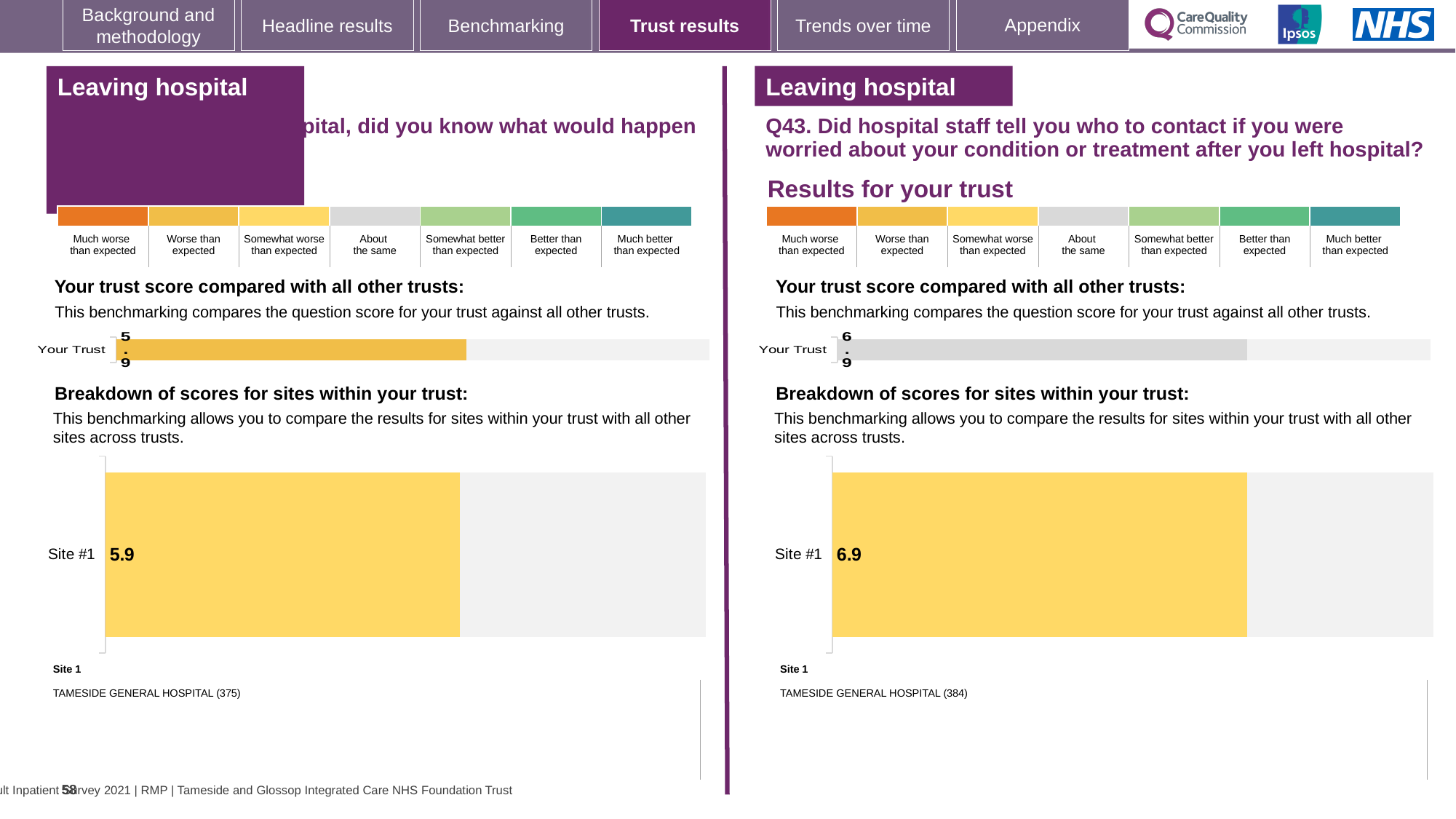
What is the difference between the Site #1 score on the Q43 panel and the Site #1 score on the left panel? 1.0 On the Q43 panel, which hospital is listed as Site 1 below the chart? TAMESIDE GENERAL HOSPITAL On the Q43 panel (right), what score is shown for Site #1 in the breakdown of sites chart? 6.9 On the left panel, what score is shown for Site #1 in the breakdown of sites chart? 5.9 On the left panel, what is the 'Your Trust' score shown in the trust benchmarking bar? 5.9 Which panel shows the higher Site #1 score, the left panel or the Q43 panel on the right? Q43 panel (right) How many sites are shown in the breakdown of sites chart on the Q43 panel? 1 What type of chart is used for the breakdown of scores for sites within your trust on the Q43 panel? Bar chart On the Q43 panel, what number appears in brackets after the Site 1 hospital name? 384 How many bars are plotted in the 'Your Trust' benchmarking chart on the left panel? 1 Which panel shows the higher 'Your Trust' score, the left panel or the Q43 panel on the right? Q43 panel (right) On the Q43 panel (right), what is the 'Your Trust' score shown in the trust benchmarking bar? 6.9